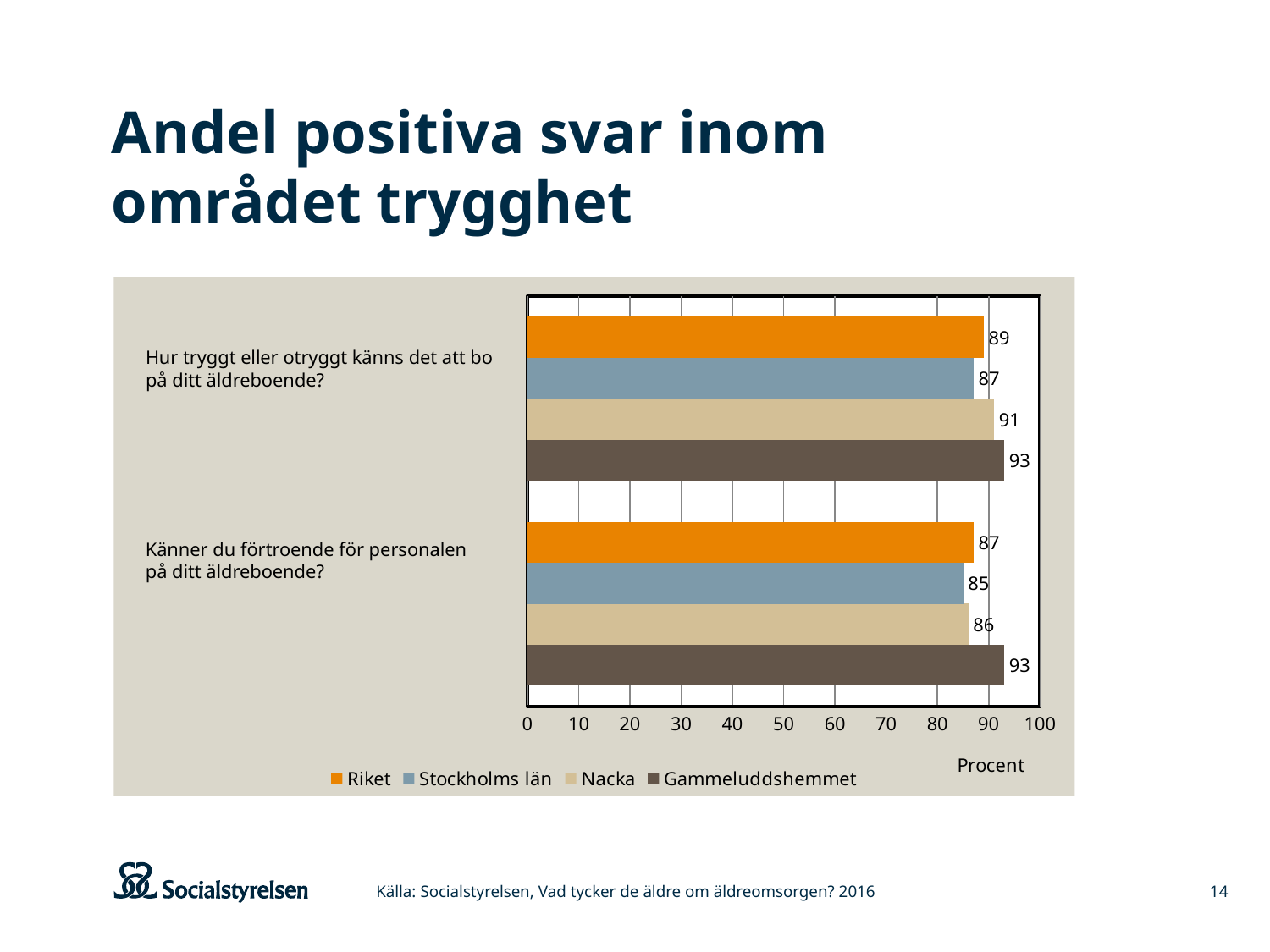
What value is shown for Gammeluddshemmet for the question 'Hur tryggt eller otryggt känns det att bo på ditt äldreboende?' 93 What kind of chart is shown on the slide? Bar chart What value is shown for Nacka for the question 'Hur tryggt eller otryggt känns det att bo på ditt äldreboende?' 91 How many questions (categories) are shown on the chart? 2 Which series has the highest value for the question 'Känner du förtroende för personalen på ditt äldreboende?' Gammeluddshemmet What unit is labelled on the horizontal axis? Procent What is the difference between Gammeluddshemmet and Nacka for the question 'Känner du förtroende för personalen på ditt äldreboende?' 7 How many series does the legend list? 4 Which is larger for the question 'Hur tryggt eller otryggt känns det att bo på ditt äldreboende?': Riket or Nacka? Nacka Which series has the lowest value for the question 'Hur tryggt eller otryggt känns det att bo på ditt äldreboende?' Stockholms län What value is shown for Riket for the question 'Känner du förtroende för personalen på ditt äldreboende?' 87 What value is shown for Stockholms län for the question 'Känner du förtroende för personalen på ditt äldreboende?' 85